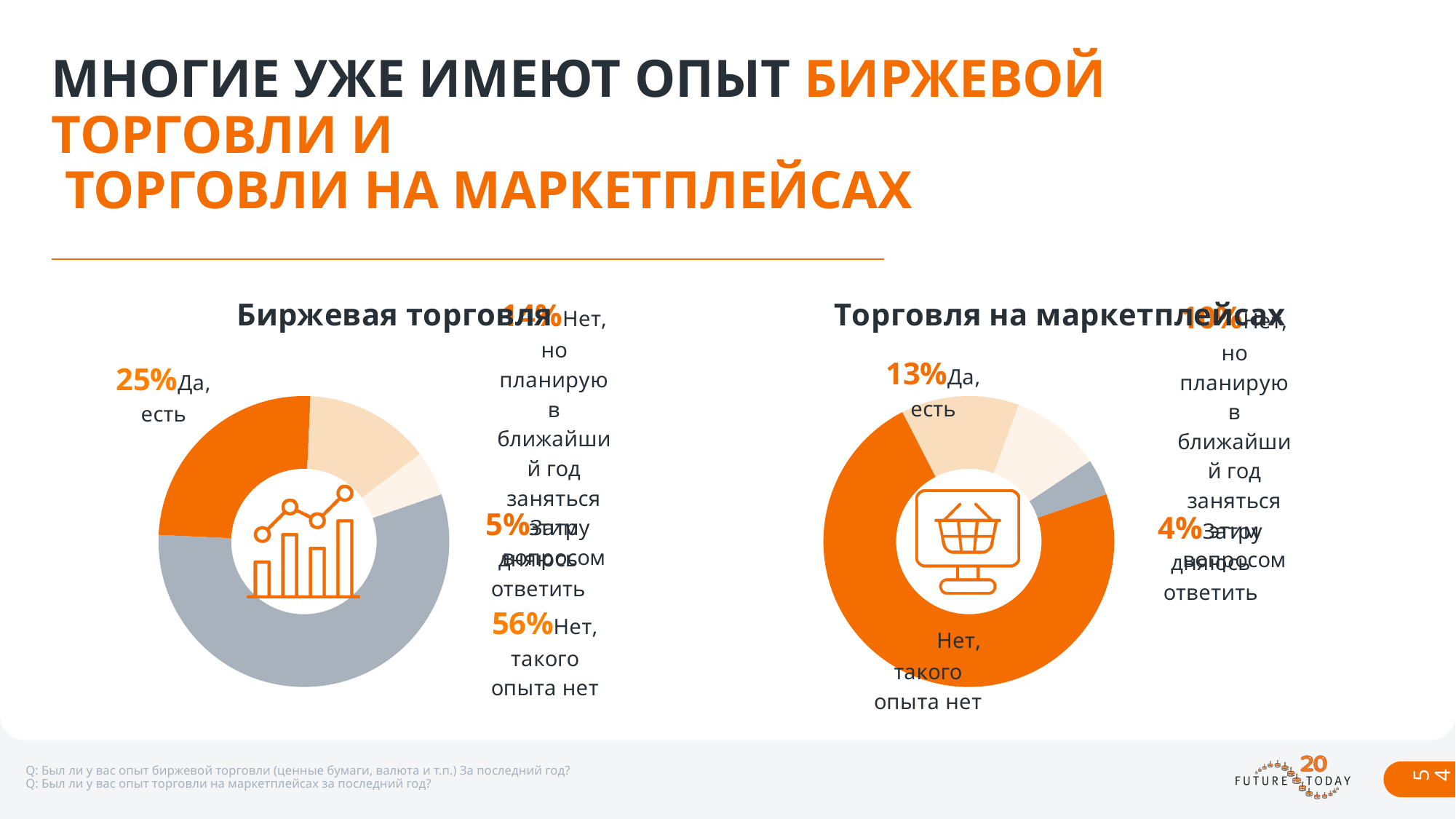
Which chart has the larger share for "Да, есть": "Биржевая торговля" or "Торговля на маркетплейсах"? Биржевая торговля In the "Торговля на маркетплейсах" chart, what share is "Затрудняюсь ответить"? 4% In the "Биржевая торговля" chart, what share is "Нет, но планирую в ближайший год заняться"? 14% In the "Биржевая торговля" chart, what share is "Нет, такого опыта нет"? 56% In the "Биржевая торговля" chart, which category has the smallest share? Затрудняюсь ответить What kind of chart is used for "Биржевая торговля"? doughnut chart In the "Биржевая торговля" chart, what share is "Затрудняюсь ответить"? 5% In the "Торговля на маркетплейсах" chart, what share is "Да, есть"? 13% In the "Биржевая торговля" chart, how many percentage points larger is "Нет, такого опыта нет" than "Да, есть"? 31 percentage points How many categories does the "Биржевая торговля" chart show? 4 In the "Биржевая торговля" chart, what share is "Да, есть"? 25% In the "Биржевая торговля" chart, which category has the largest share? Нет, такого опыта нет